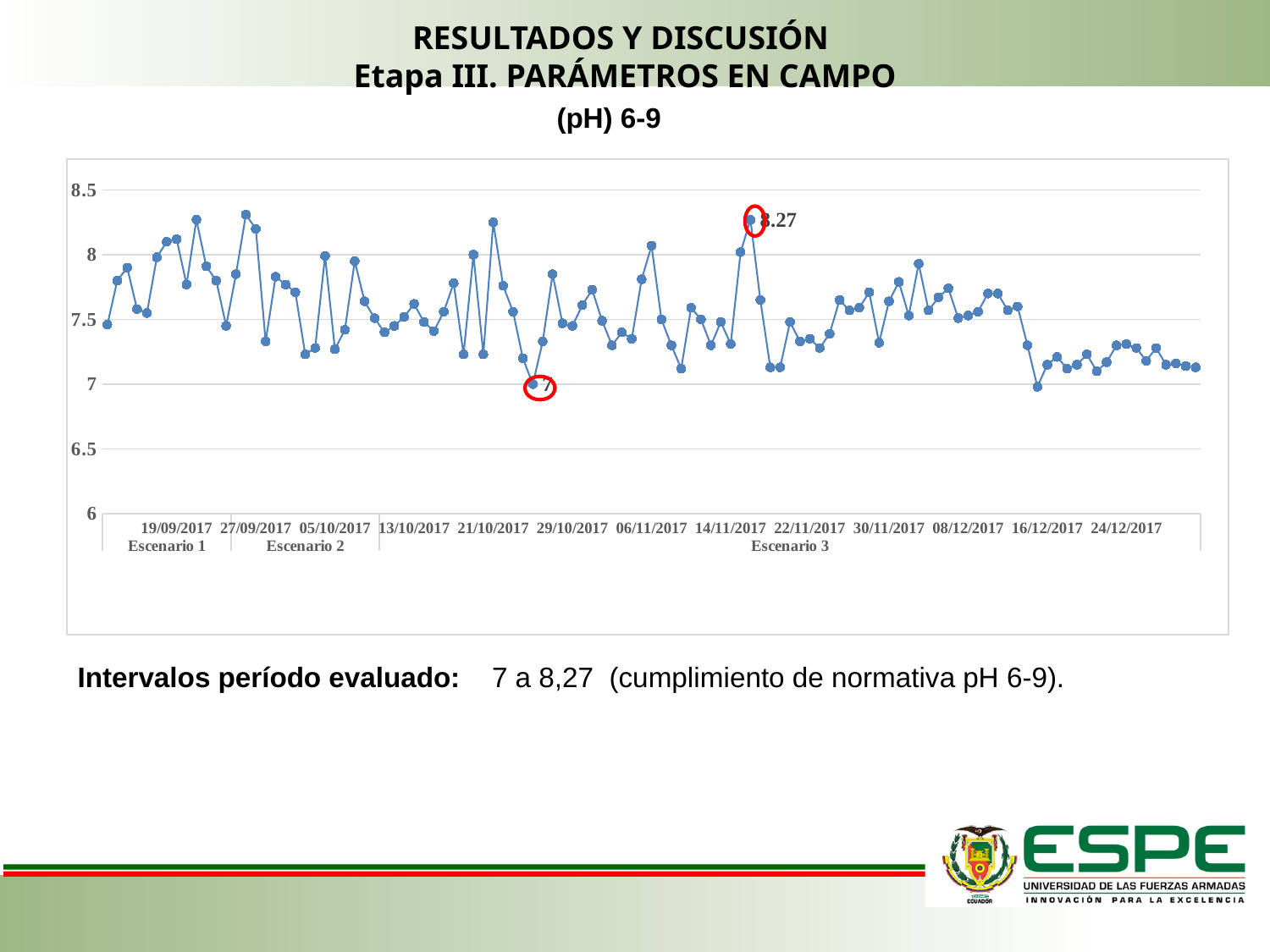
Is the lowest labeled value on the chart greater or less than 7.5? less What is the lowest pH value labeled on the chart? 7 Which is larger, the labeled value 8.27 or the labeled value 7? 8.27 What is the highest value shown on the y axis? 8.5 What kind of chart is shown on the slide? line chart Is the highest labeled value on the chart greater or less than 8? greater Are the values plotted after 24/12/2017 greater or less than 7.5? less What is the difference between the highest labeled value (8.27) and the lowest labeled value (7)? 1.27 In which scenario (Escenario) does the highest labeled value 8.27 occur? Escenario 3 What is the highest pH value labeled on the chart? 8.27 How many scenarios (Escenario) are labeled along the x axis? 3 What is the lowest value shown on the y axis? 6